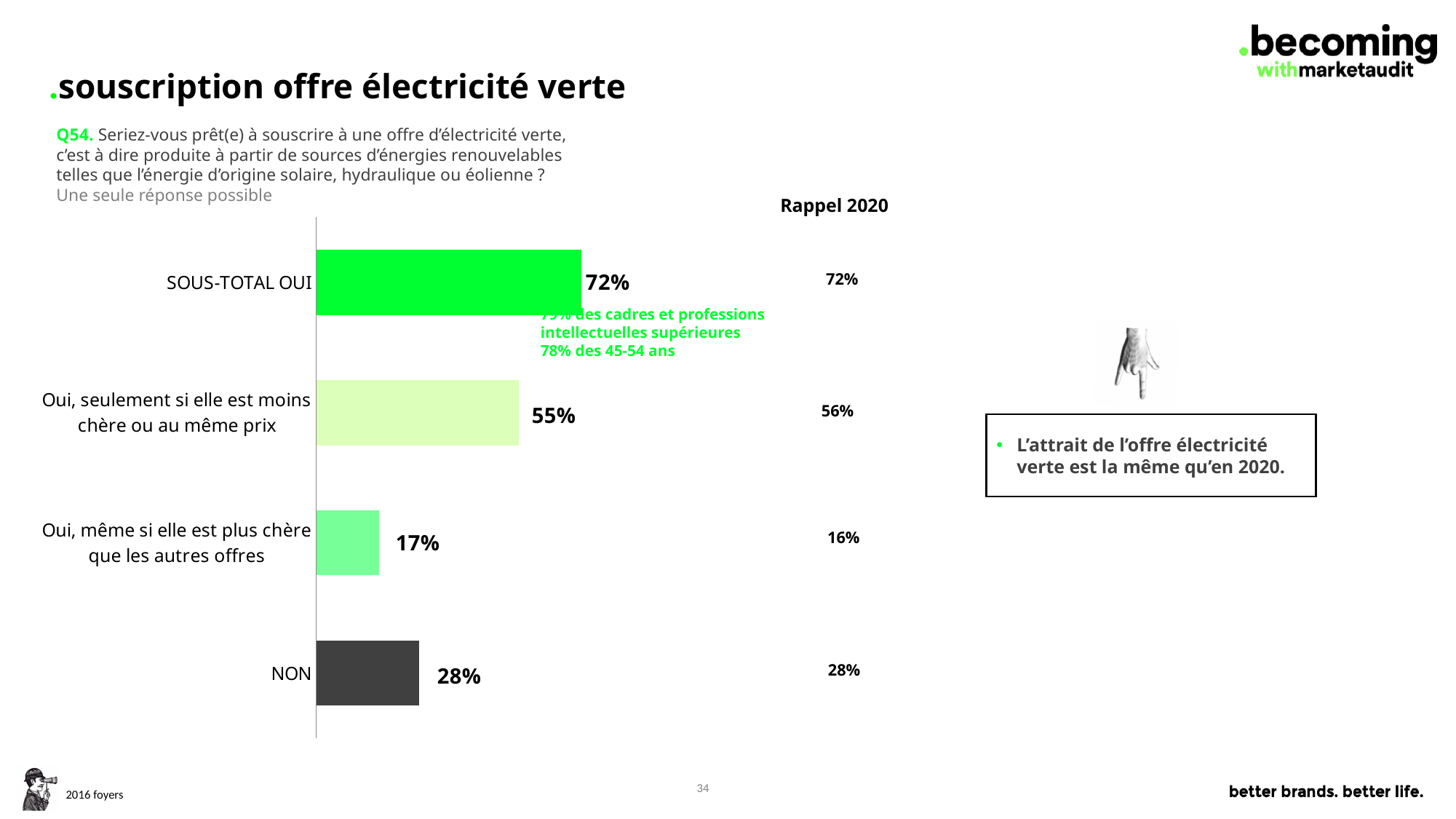
What is the value for "Oui, même si elle est plus chère que les autres offres"? 17% Which category has the lowest value? Oui, même si elle est plus chère que les autres offres Which is larger: the value for NON or the value for "Oui, même si elle est plus chère que les autres offres"? NON How many bars are shown in the chart? 4 What kind of chart is shown on the slide? Bar chart What is the value for "Oui, seulement si elle est moins chère ou au même prix"? 55% What is the difference between the values for SOUS-TOTAL OUI and NON? 44 percentage points Which category has the highest value? SOUS-TOTAL OUI What is the value for NON? 28% What colour is the NON bar? Dark grey What is the Rappel 2020 value shown for "Oui, seulement si elle est moins chère ou au même prix"? 56% What is the value for SOUS-TOTAL OUI? 72%